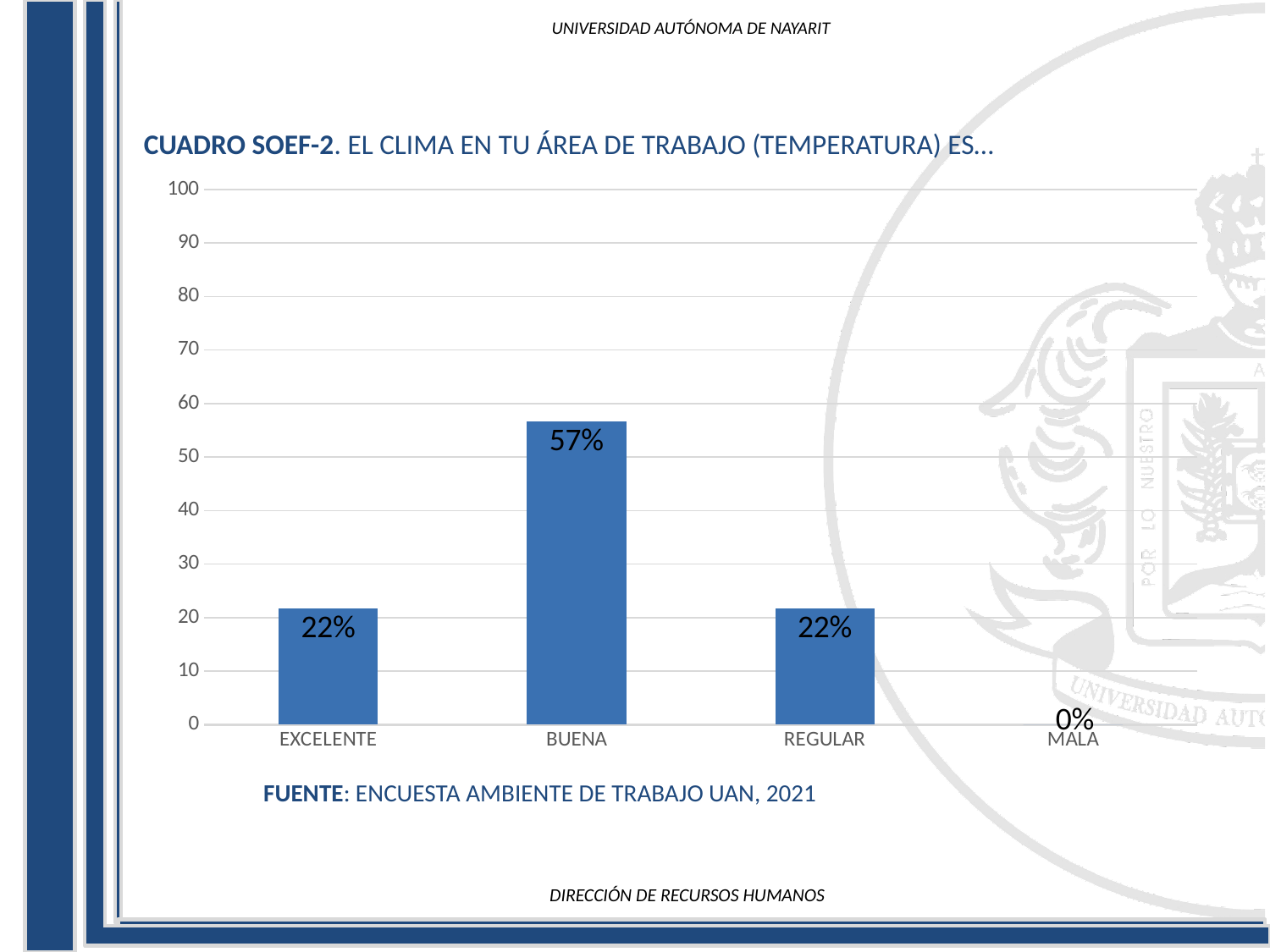
What is the difference between the values for BUENA and REGULAR? 35% What source is cited below the chart? ENCUESTA AMBIENTE DE TRABAJO UAN, 2021 What kind of chart is shown on the slide? bar chart What is the title of the chart? CUADRO SOEF-2. EL CLIMA EN TU ÁREA DE TRABAJO (TEMPERATURA) ES… How many categories are shown on the x axis? 4 What is the value for BUENA? 57% Which category has the highest value? BUENA Is the value for BUENA greater or less than 50? greater What is the value for MALA? 0% What is the value for EXCELENTE? 22% Which is larger, the value for BUENA or the value for EXCELENTE? BUENA Which category has the lowest value? MALA